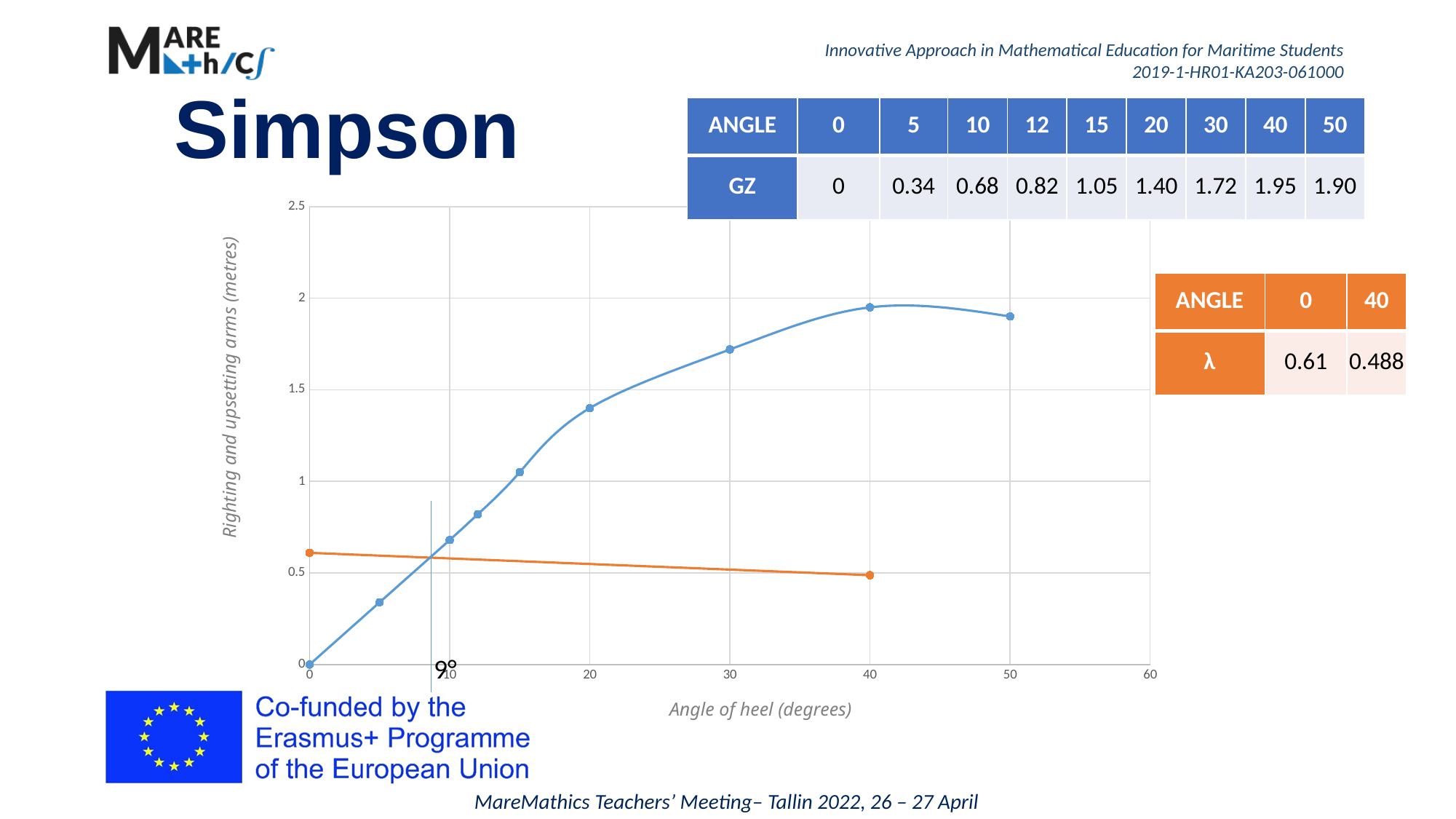
Which is larger: the GZ value at 30 degrees or the λ value at 0 degrees? GZ at 30 degrees What kind of chart is shown on the slide? line chart How many data points are plotted on the GZ curve? 9 What is the GZ value at an angle of 12 degrees? 0.82 What is the difference between the λ values at 0 degrees and 40 degrees? 0.122 Does the orange λ line rise or fall as the angle of heel increases? fall What is the λ value at an angle of 40 degrees? 0.488 What is the difference between the GZ values at 40 degrees and 50 degrees? 0.05 What is the GZ value at an angle of 20 degrees? 1.40 At which angle does the GZ curve reach its highest value? 40 What is the label of the x axis of the chart? Angle of heel (degrees) Is the GZ value at 30 degrees greater or less than 1.5? greater